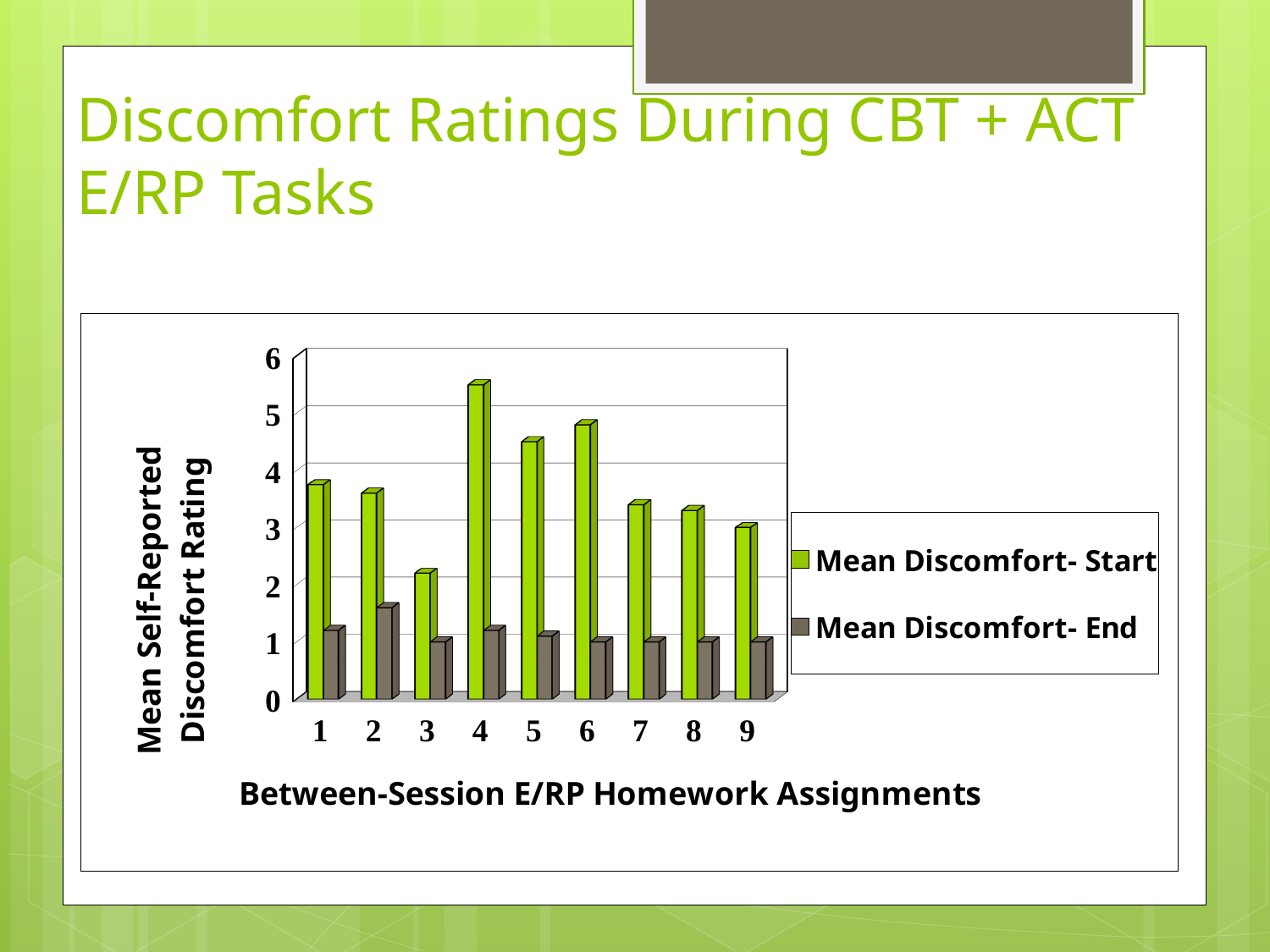
Is the Mean Discomfort- Start value for assignment 1 greater or less than 4? less What is the title of the x axis? Between-Session E/RP Homework Assignments Is the Mean Discomfort- End value for assignment 2 greater or less than 1? greater How many homework assignments are shown along the x axis? 9 Is the Mean Discomfort- Start value for assignment 4 greater or less than 5? greater Which homework assignment has the highest Mean Discomfort- End value? 2 Which is larger, the Mean Discomfort- Start value for assignment 1 or for assignment 3? assignment 1 Which is larger, the Mean Discomfort- Start value for assignment 4 or for assignment 5? assignment 4 Which homework assignment has the highest Mean Discomfort- Start value? 4 What kind of chart is shown on the slide? bar chart Which homework assignment has the lowest Mean Discomfort- Start value? 3 How many series does the legend list? 2